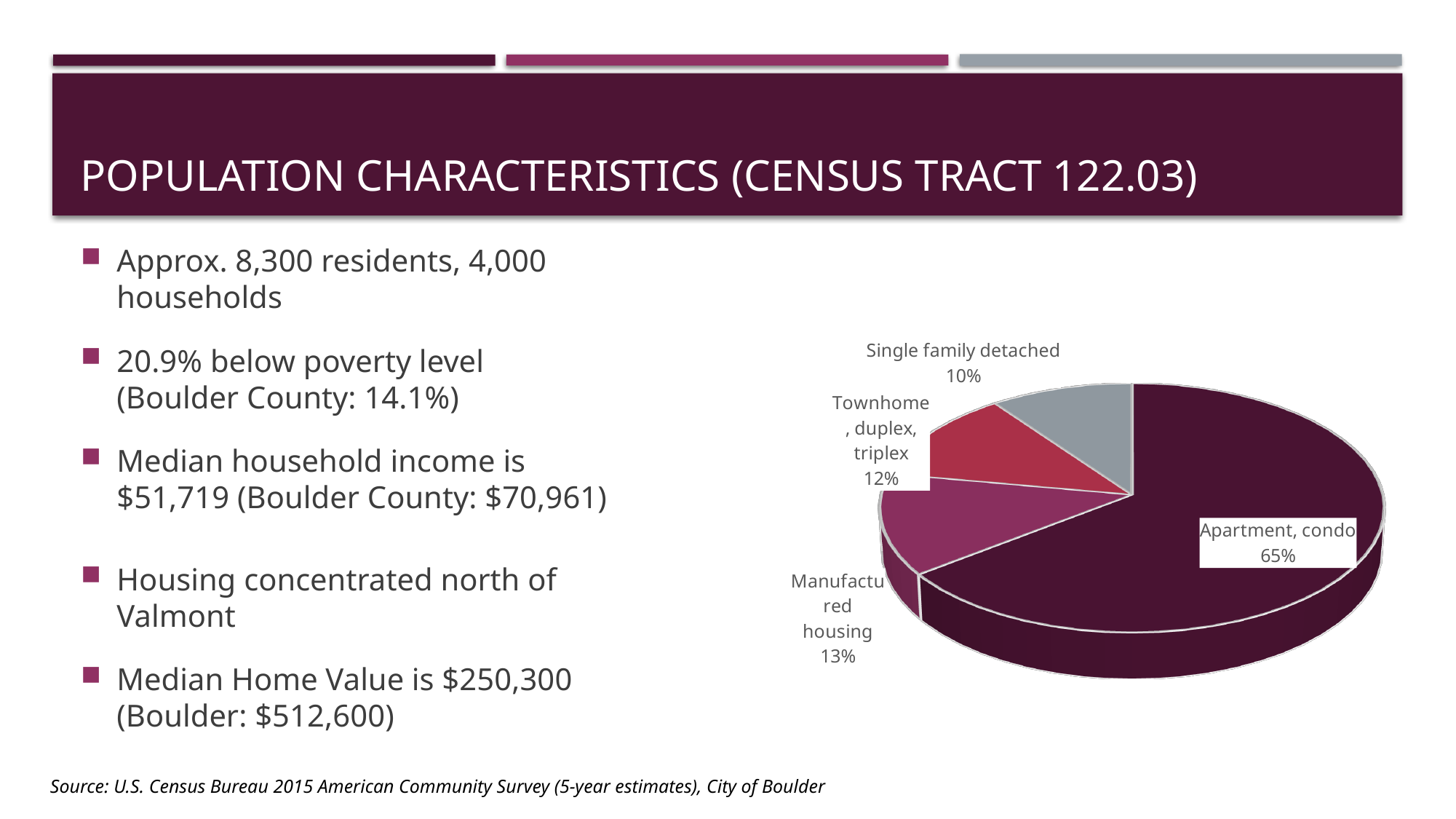
How many categories are shown in the pie chart? 4 Which category has the smallest slice of the pie chart? Single family detached Which is larger, the share for Townhome, duplex, triplex or the share for Single family detached? Townhome, duplex, triplex What kind of chart is shown on the slide? Pie chart What share of the pie chart is Manufactured housing? 13% What is the difference in percentage points between Apartment, condo and Manufactured housing? 52 What colour is the Single family detached slice of the pie chart? Grey What is the difference in percentage points between Manufactured housing and Single family detached? 3 What share of the pie chart is Townhome, duplex, triplex? 12% What share of the pie chart is Single family detached? 10% Which category has the largest slice of the pie chart? Apartment, condo What share of the pie chart is Apartment, condo? 65%